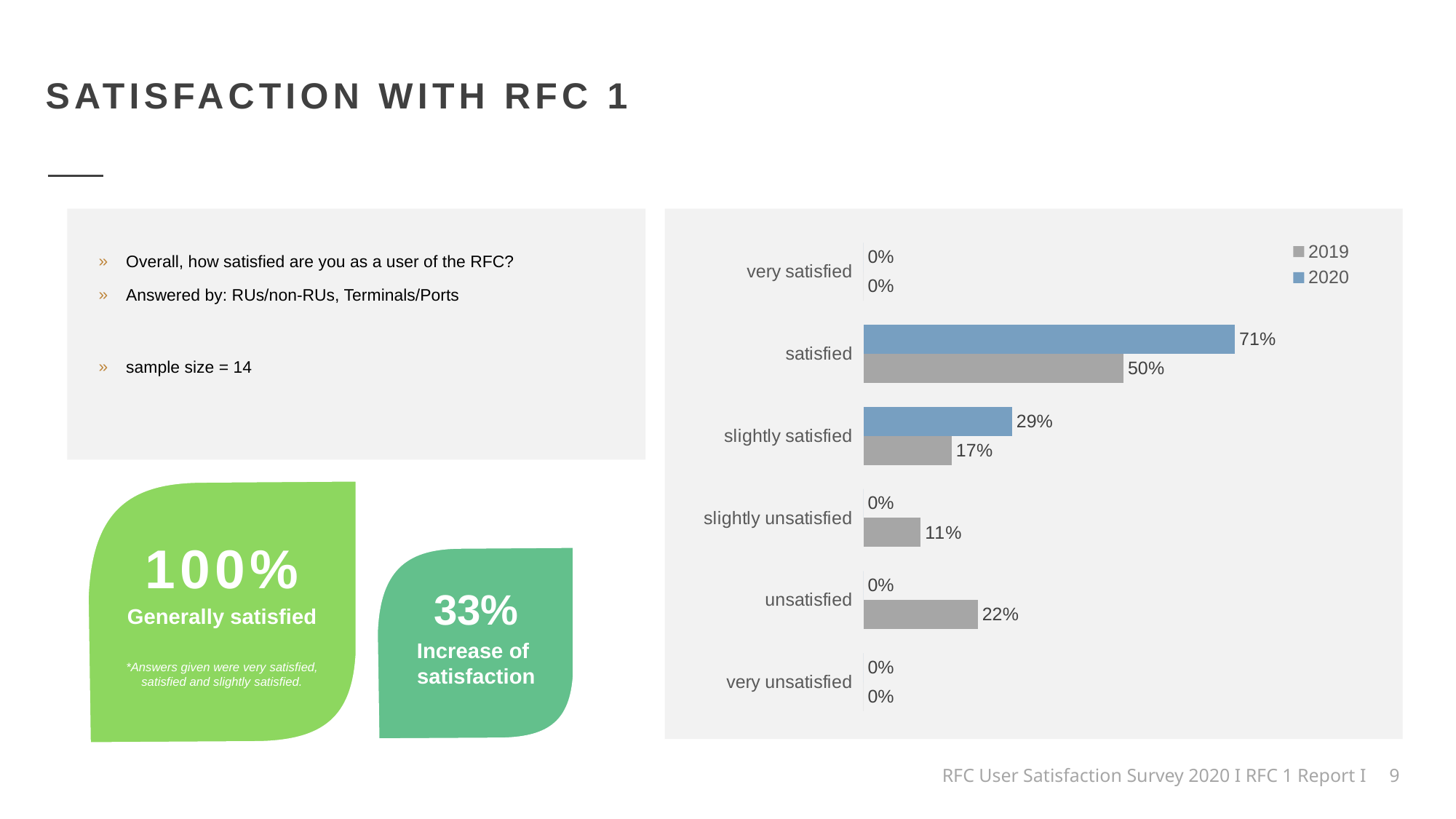
How many series does the chart legend list? 2 What is the 2020 value for "satisfied"? 71% What is the 2019 value for "unsatisfied"? 22% How many categories are shown on the chart? 6 What is the difference between the 2020 and 2019 values for "satisfied"? 21% What is the difference between the 2019 values for "unsatisfied" and "slightly unsatisfied"? 11% Which colour represents the 2020 series in the chart? blue Which is larger for "slightly satisfied": the 2019 value or the 2020 value? 2020 What kind of chart is shown on the slide? bar chart Which category has the highest 2019 value? satisfied What is the 2019 value for "satisfied"? 50% What is the 2020 value for "slightly satisfied"? 29%